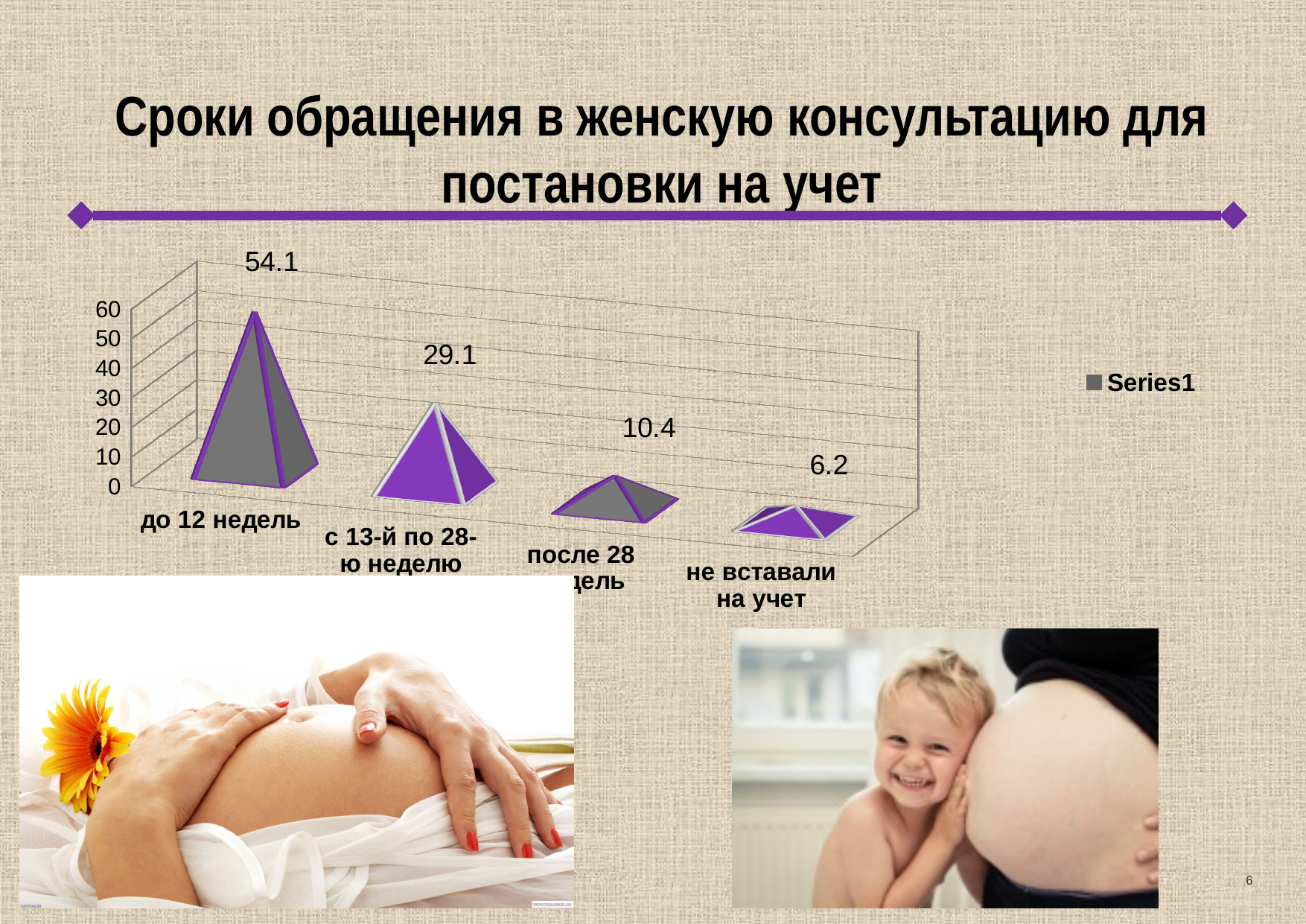
Which category has the lowest value? не вставали на учет What is the value for "с 13-й по 28-ю неделю"? 29.1 What is the value for the third category, "после 28 ..."? 10.4 What kind of chart is shown on the slide? bar chart How many categories are shown on the chart? 4 Which is larger, the value for "с 13-й по 28-ю неделю" or the value for "не вставали на учет"? с 13-й по 28-ю неделю What is the difference between the values for "до 12 недель" and "с 13-й по 28-ю неделю"? 25.0 Which category has the highest value? до 12 недель What is the value for "не вставали на учет"? 6.2 What is the value for "до 12 недель"? 54.1 How many series does the legend list? 1 Do the values rise or fall from left to right along the x axis? fall